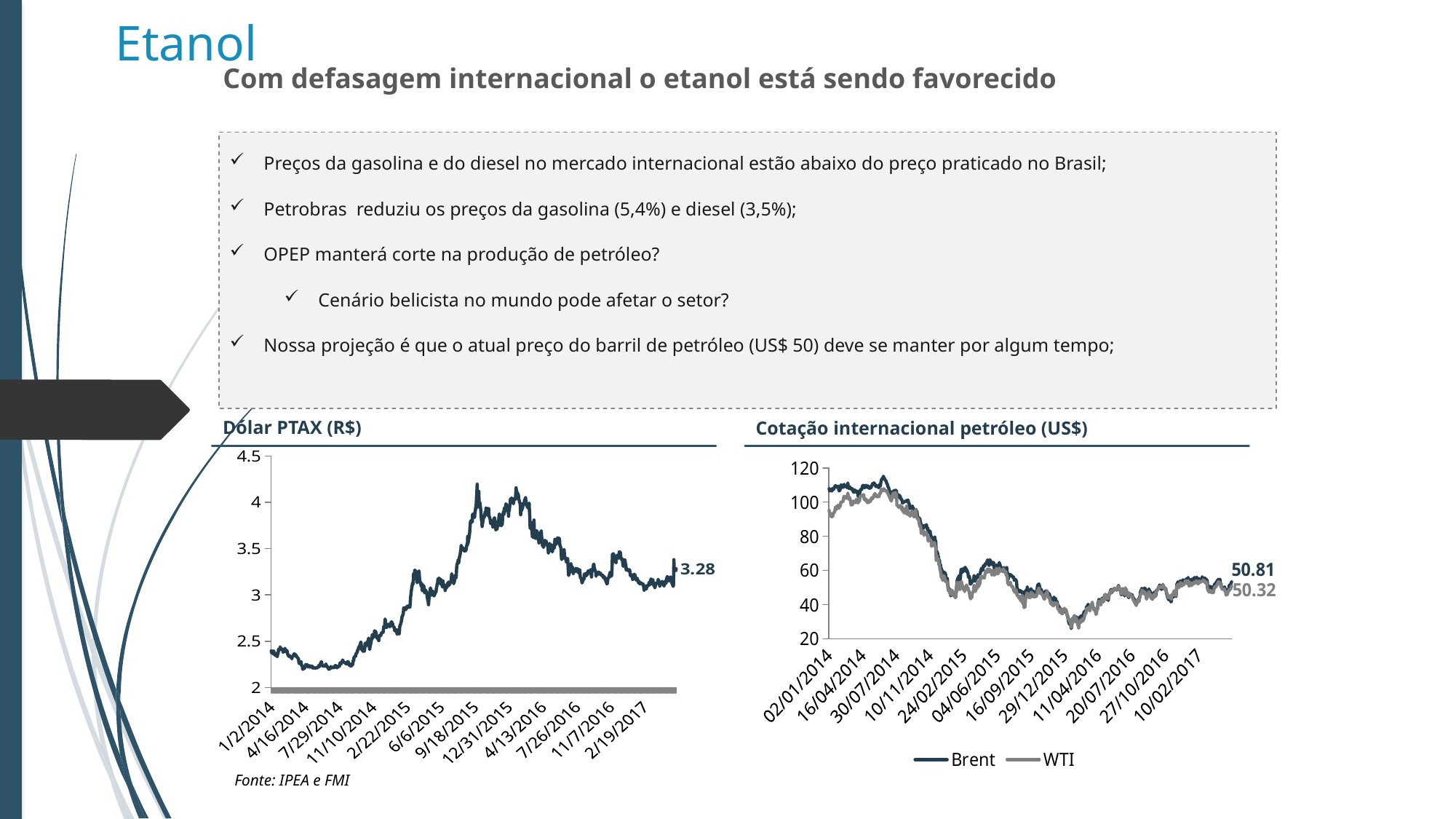
In the 'Dólar PTAX (R$)' chart, is the value at the start of the series (1/2/2014) greater or less than 2.5? less What kind of chart is the 'Dólar PTAX (R$)' chart? line chart How many series does the legend of the 'Cotação internacional petróleo (US$)' chart list? 2 In the 'Dólar PTAX (R$)' chart, is the highest value reached by the line greater or less than 4? greater In the 'Cotação internacional petróleo (US$)' chart, is the Brent value at 02/01/2014 greater or less than 100? greater In the 'Cotação internacional petróleo (US$)' chart, what is the final labelled value for WTI? 50.32 In the 'Cotação internacional petróleo (US$)' chart, do the values overall rise or fall from the start of 2014 to the end of the period? fall In the 'Cotação internacional petróleo (US$)' chart, what is the final labelled value for Brent? 50.81 What are the legend entries of the 'Cotação internacional petróleo (US$)' chart? Brent and WTI In the 'Cotação internacional petróleo (US$)' chart, which series has the higher final labelled value, Brent or WTI? Brent In the 'Cotação internacional petróleo (US$)' chart, what is the difference between the final labelled values of Brent and WTI? 0.49 In the 'Dólar PTAX (R$)' chart, what is the value shown by the data label at the end of the line? 3.28